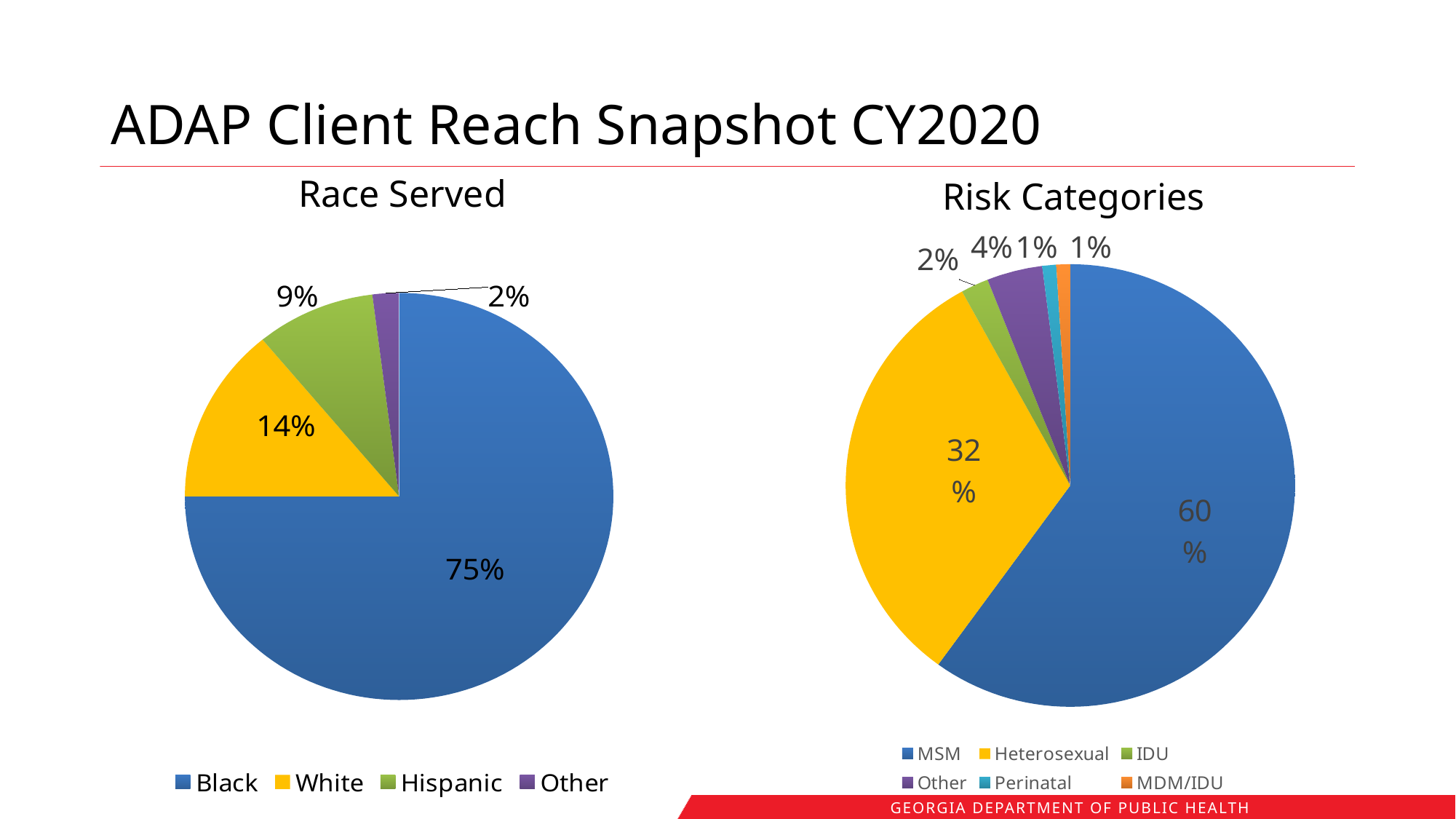
In the Risk Categories chart, which is larger, the Other slice or the IDU slice? Other In the Risk Categories chart, how many categories does the legend list? 6 In the Race Served chart, what share of clients are Black? 75% In the Race Served chart, what percentage is shown for Hispanic? 9% In the Risk Categories chart, what is the difference between the MSM and Heterosexual shares? 28% What type of chart is the Race Served chart? Pie chart In the Race Served chart, how many categories does the legend list? 4 In the Risk Categories chart, which category has the largest slice? MSM In the Race Served chart, which race has the smallest slice? Other In the Risk Categories chart, what percentage is shown for Heterosexual? 32% In the Risk Categories chart, what percentage is shown for MSM? 60% In the Race Served chart, what is the difference between the White and Hispanic shares? 5%